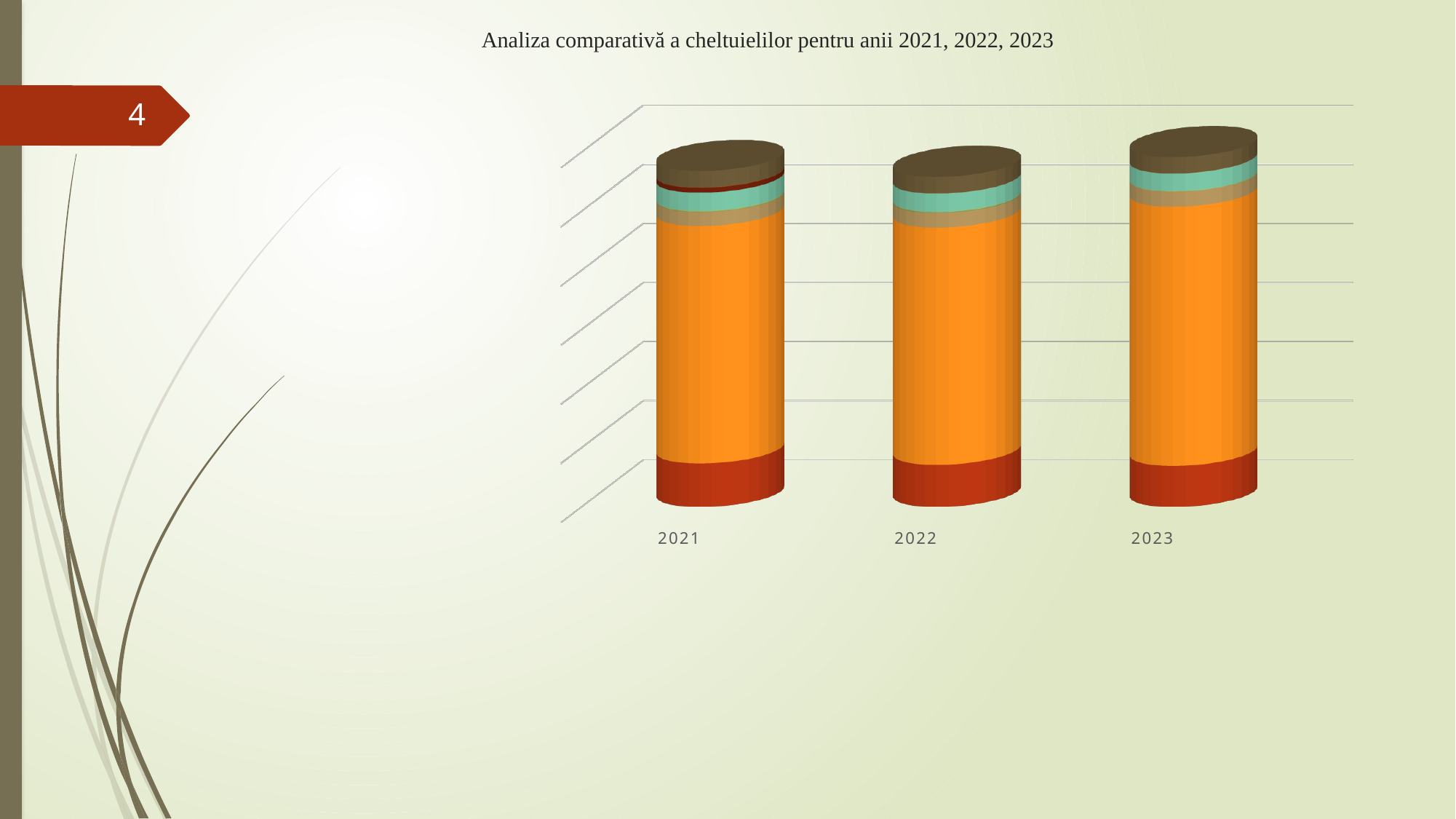
Is the total stacked bar for 2023 taller or shorter than the bar for 2022? Taller How many categories (years) are shown on the x axis of the chart? 3 Which year has the tallest stacked bar in the chart? 2023 What is the title of the chart on the slide? Analiza comparativă a cheltuielilor pentru anii 2021, 2022, 2023 What is the last category label on the x axis of the chart? 2023 What is the first category label on the x axis of the chart? 2021 Which colour segment takes up the largest portion of each stacked bar? Orange What kind of chart is shown on the slide? Stacked bar chart